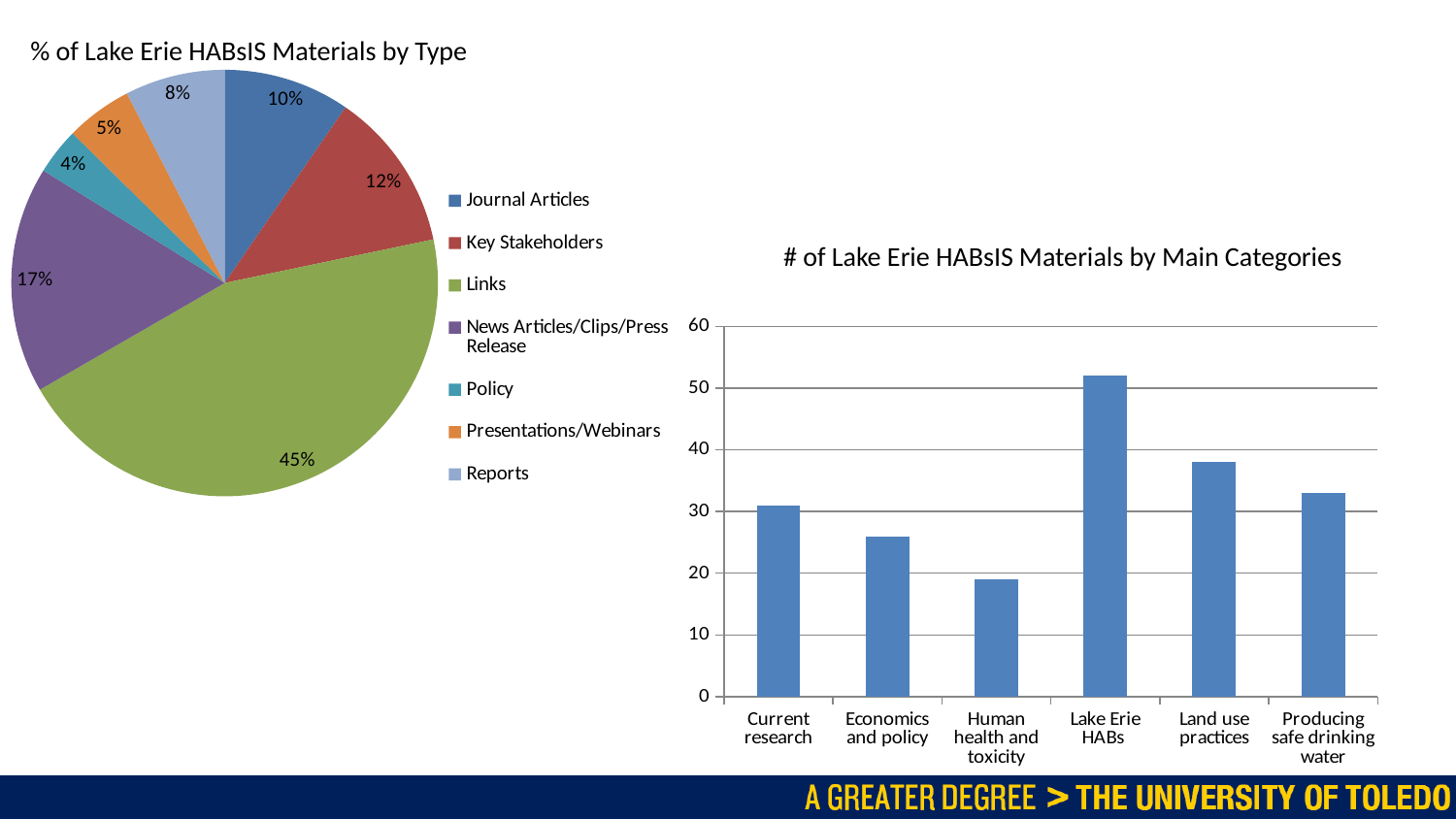
In the pie chart '% of Lake Erie HABsIS Materials by Type', what is the difference between the shares of News Articles/Clips/Press Release and Key Stakeholders? 5% In the bar chart '# of Lake Erie HABsIS Materials by Main Categories', which category has the lowest value? Human health and toxicity In the pie chart '% of Lake Erie HABsIS Materials by Type', which is larger, the share for Reports or the share for Presentations/Webinars? Reports In the pie chart '% of Lake Erie HABsIS Materials by Type', which type has the largest share? Links In the bar chart '# of Lake Erie HABsIS Materials by Main Categories', how many categories are shown on the x axis? 6 In the bar chart '# of Lake Erie HABsIS Materials by Main Categories', which category has the highest value? Lake Erie HABs What kind of chart is '# of Lake Erie HABsIS Materials by Main Categories'? Bar chart In the pie chart '% of Lake Erie HABsIS Materials by Type', how many types are listed in the legend? 7 In the pie chart '% of Lake Erie HABsIS Materials by Type', what share do Links have? 45% In the pie chart '% of Lake Erie HABsIS Materials by Type', what share do Journal Articles have? 10% In the bar chart '# of Lake Erie HABsIS Materials by Main Categories', is the value for Land use practices greater or less than 30? greater In the pie chart '% of Lake Erie HABsIS Materials by Type', which type has the smallest share? Policy